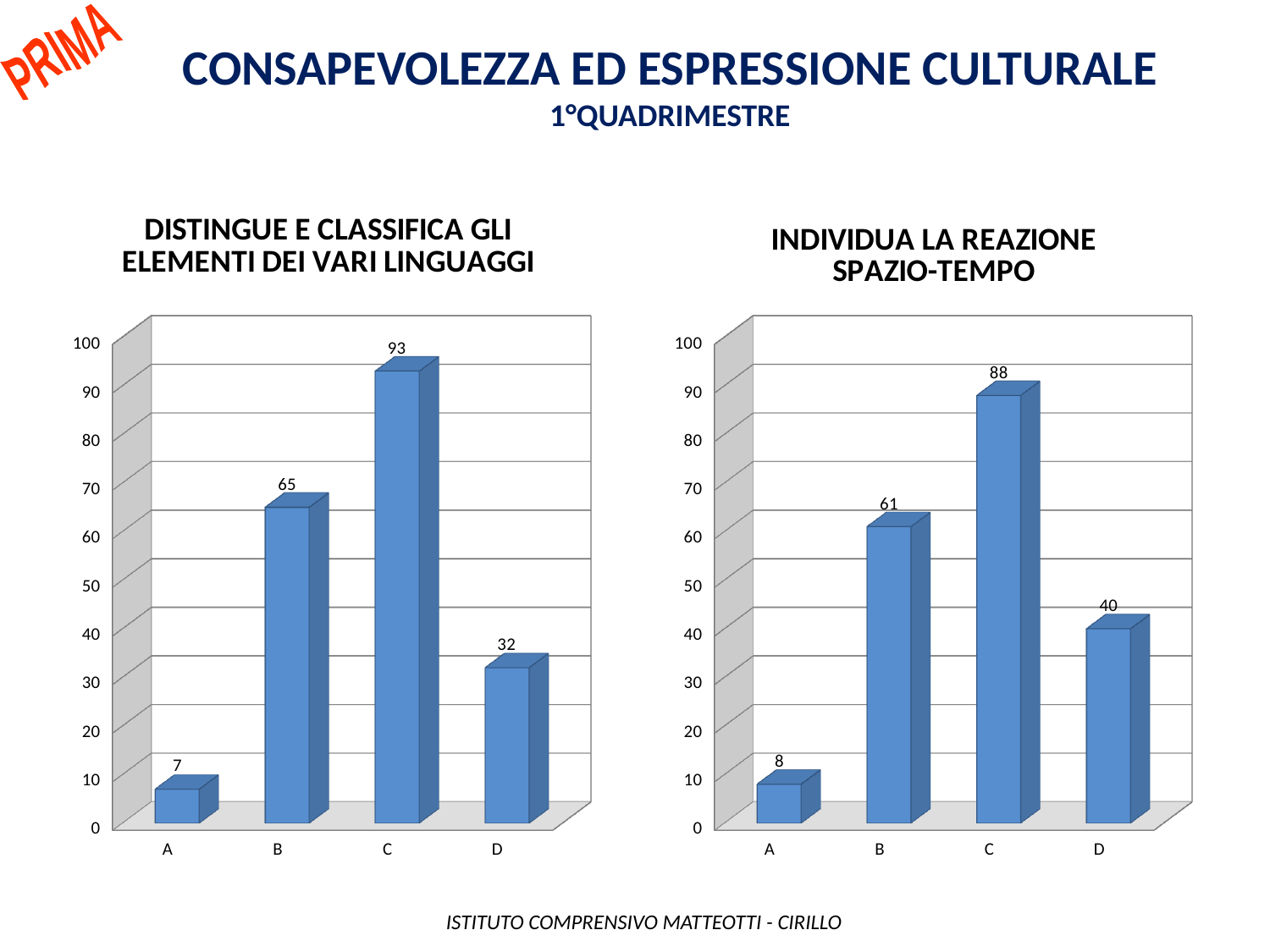
In the right chart, which category has the highest value? C In the right chart, what is the difference between the values for D and A? 32 What is the title of the chart on the right? INDIVIDUA LA REAZIONE SPAZIO-TEMPO What kind of chart is the one titled 'DISTINGUE E CLASSIFICA GLI ELEMENTI DEI VARI LINGUAGGI'? Bar chart In the left chart, what is the difference between the values for C and B? 28 In the chart titled 'DISTINGUE E CLASSIFICA GLI ELEMENTI DEI VARI LINGUAGGI', what is the value for category C? 93 In the left chart, which category has the lowest value? A In the chart titled 'INDIVIDUA LA REAZIONE SPAZIO-TEMPO', what is the value for category B? 61 In the right chart, which is larger, the value for B or the value for D? B In the left chart, is the value for D greater or less than 40? less In the left chart, what is the value for category A? 7 How many categories are shown in the chart titled 'INDIVIDUA LA REAZIONE SPAZIO-TEMPO'? 4